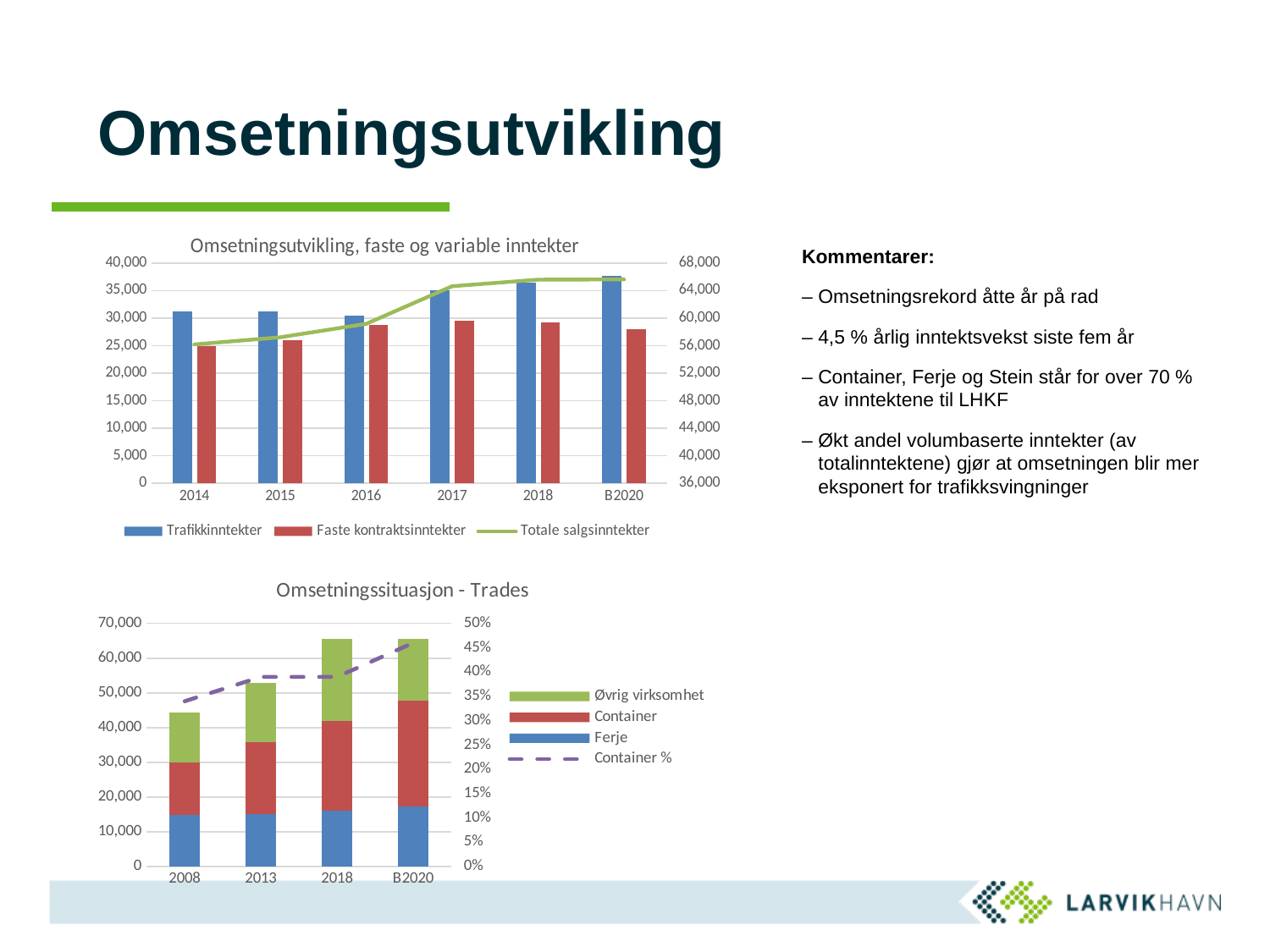
In the chart titled "Omsetningsutvikling, faste og variable inntekter", how many series does the legend list? 3 In the chart titled "Omsetningsutvikling, faste og variable inntekter", which year has the lowest Faste kontraktsinntekter? 2014 In the chart titled "Omsetningsutvikling, faste og variable inntekter", how many years are shown on the x axis? 6 In the chart titled "Omsetningssituasjon - Trades", which category has the lowest total stacked bar? 2008 In the chart titled "Omsetningssituasjon - Trades", how many categories are shown on the x axis? 4 In the chart titled "Omsetningsutvikling, faste og variable inntekter", does the Totale salgsinntekter line rise or fall from 2014 to B2020? rise In the chart titled "Omsetningsutvikling, faste og variable inntekter", is the Faste kontraktsinntekter value for 2014 greater or less than 30,000? less In the chart titled "Omsetningssituasjon - Trades", how many series does the legend list? 4 In the chart titled "Omsetningsutvikling, faste og variable inntekter", is the Trafikkinntekter value for 2018 greater or less than 35,000? greater What kind of chart is "Omsetningssituasjon - Trades"? stacked bar chart with a line In the chart titled "Omsetningsutvikling, faste og variable inntekter", which is larger in 2017: Trafikkinntekter or Faste kontraktsinntekter? Trafikkinntekter In the chart titled "Omsetningssituasjon - Trades", is the Ferje value for 2008 greater or less than 10,000? greater